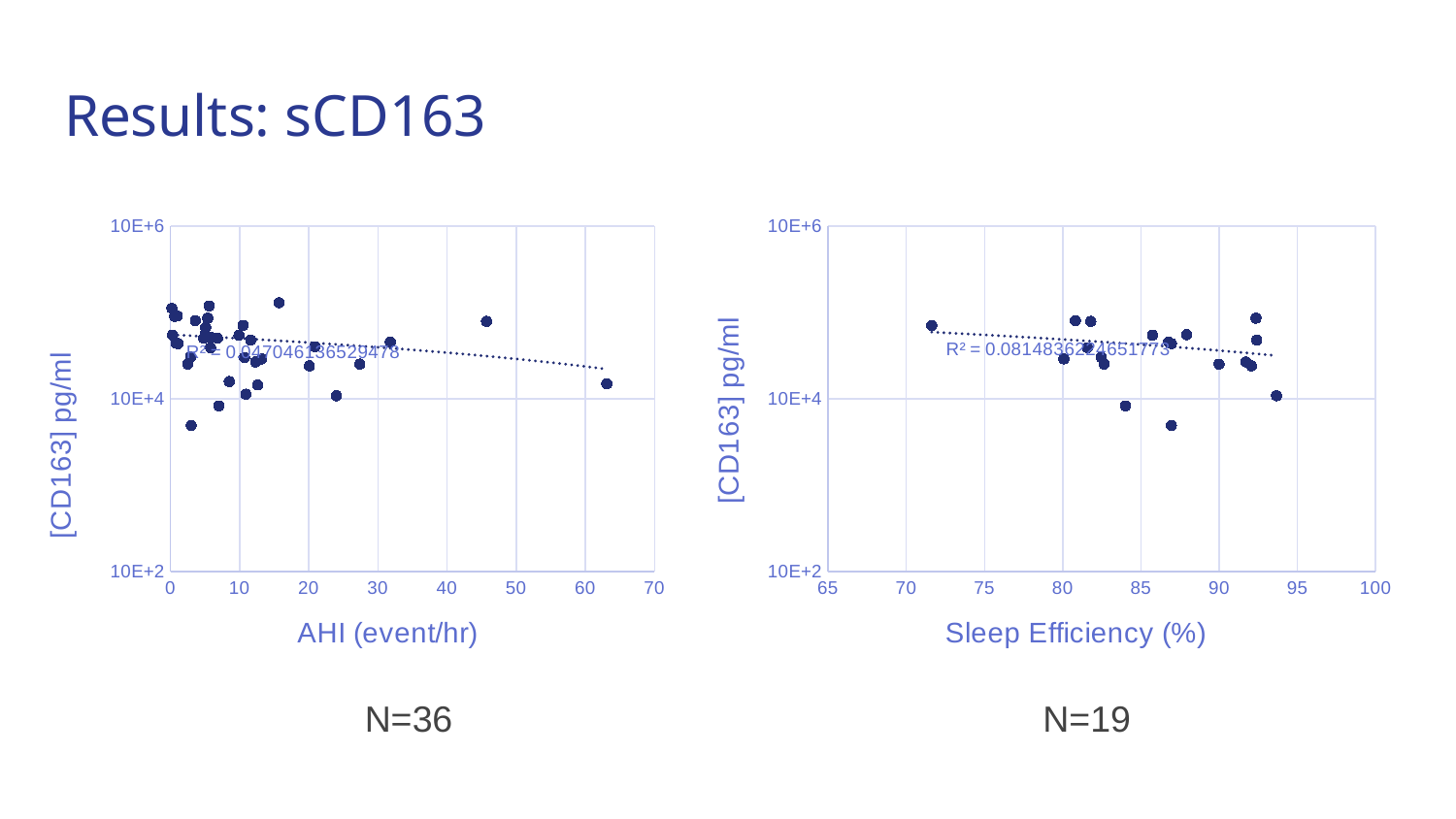
In the right chart, is the [CD163] value of the lowest point (near Sleep Efficiency 87%) greater or less than 10E+4 pg/ml? less What kind of chart is the right chart (Sleep Efficiency vs [CD163])? Scatter plot What is the y-axis label shared by both charts? [CD163] pg/ml In the left chart, does the dotted trend line rise or fall as AHI increases? Fall In the left chart (AHI), how many data points are plotted according to the N shown below it? 36 In the left chart, is the [CD163] value of the lowest point (near AHI 3) greater or less than 10E+4 pg/ml? less In the right chart, is the Sleep Efficiency of the leftmost data point greater or less than 75%? less What kind of chart is the left chart (AHI vs [CD163])? Scatter plot What is the x-axis label of the left chart? AHI (event/hr) In the right chart, does the dotted trend line rise or fall as Sleep Efficiency increases? Fall In the right chart (Sleep Efficiency), how many data points are plotted according to the N shown below it? 19